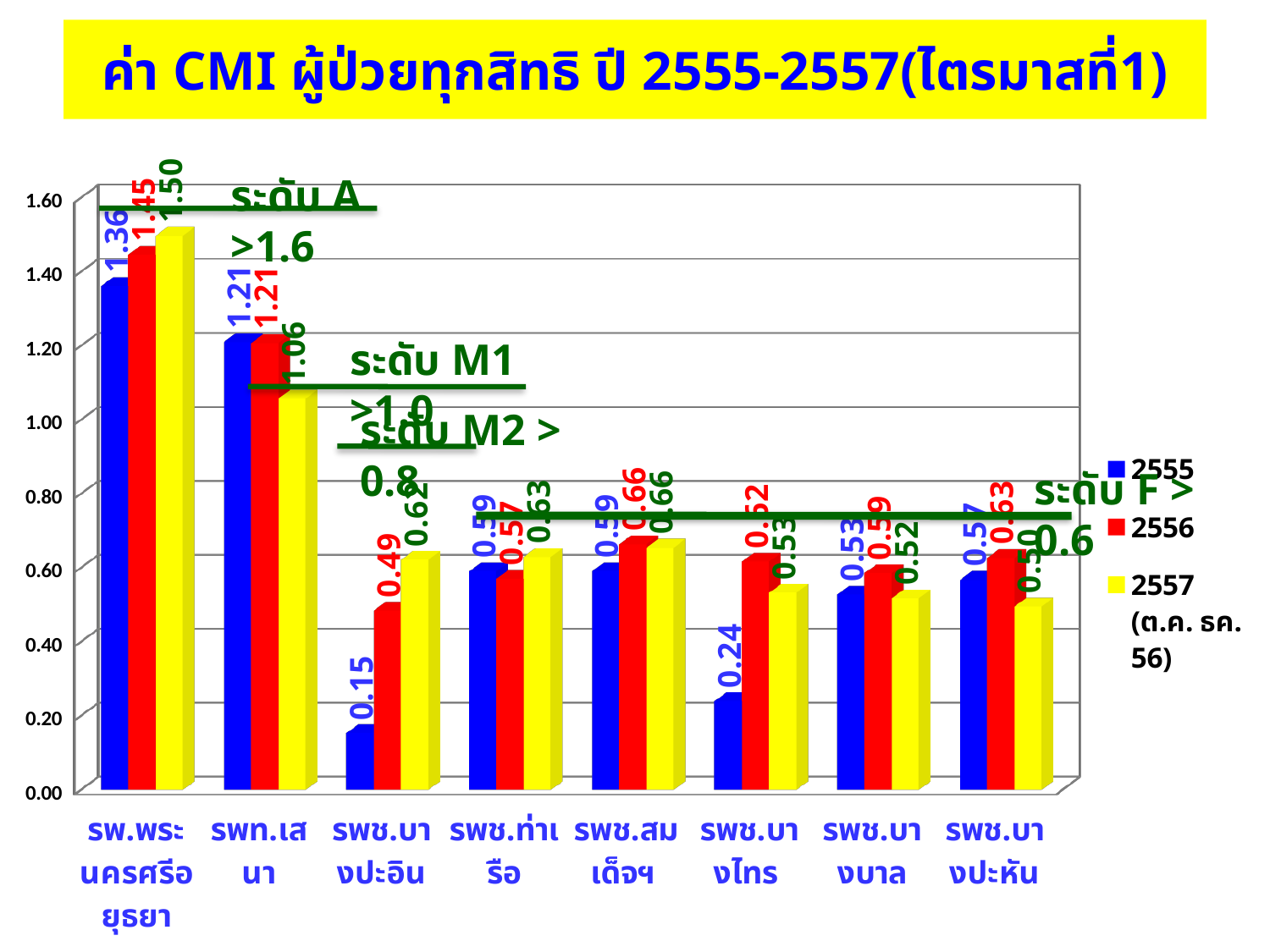
How many hospitals are shown on the x axis? 8 What is the 2557 value for รพ.พระนครศรีอยุธยา? 1.50 Is the 2555 value for รพท.เสนา greater or less than 1.00? greater What is the 2557 value for รพท.เสนา? 1.06 What is the difference between the 2556 and 2555 values for รพช.บางไทร? 0.38 What is the 2556 value for รพช.บางไทร? 0.62 What kind of chart is shown on the slide? Bar chart How many series does the legend list? 3 What is the 2555 value for รพช.บางปะอิน? 0.15 Which hospital has the highest 2556 value? รพ.พระนครศรีอยุธยา Which is larger for รพช.บางบาล: the 2556 value or the 2557 value? 2556 Which hospital has the lowest 2555 value? รพช.บางปะอิน